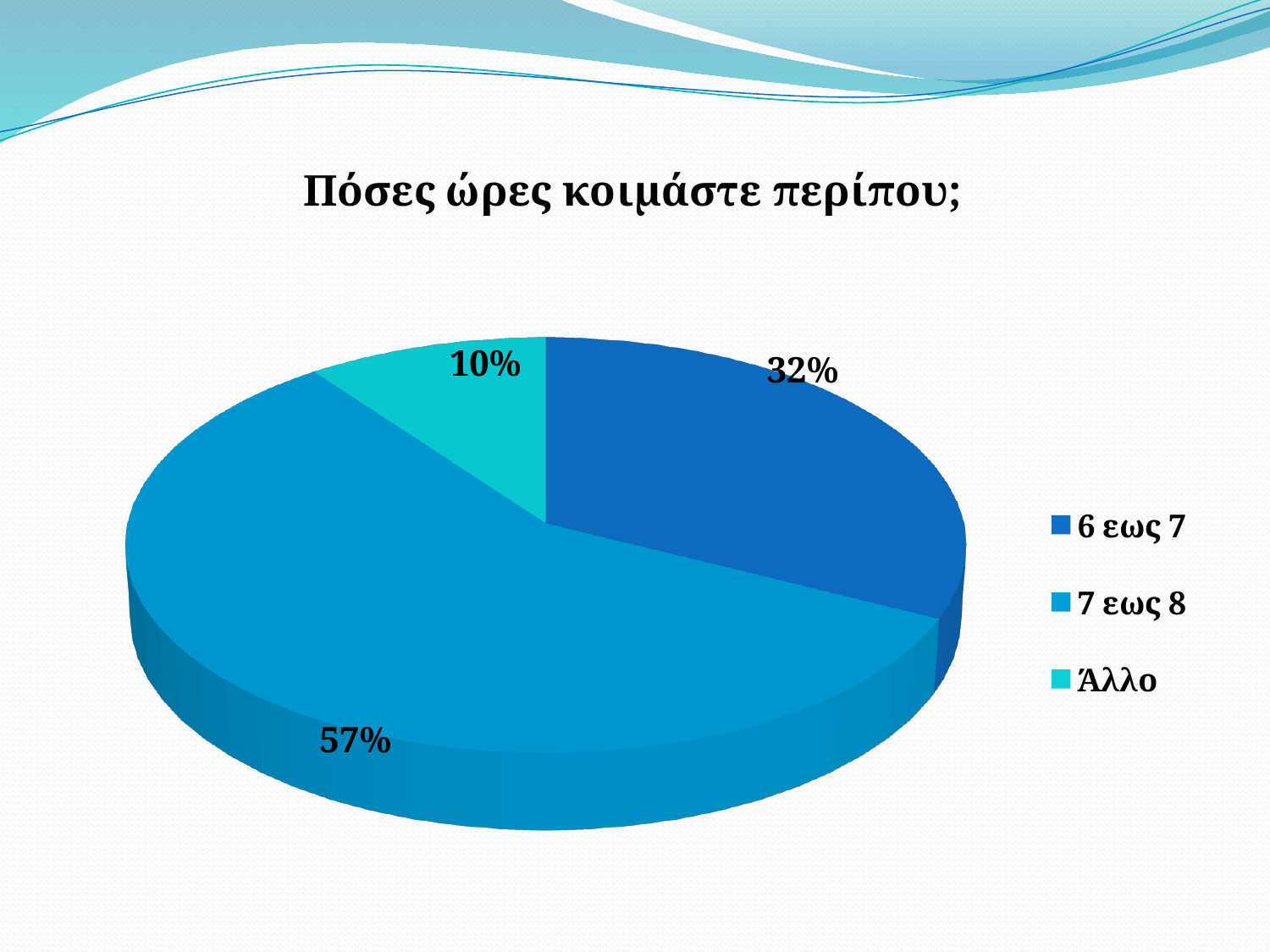
Which slice is larger, "6 εως 7" or "Άλλο"? 6 εως 7 How many categories does the pie chart show? 3 What is the difference in percentage points between the "6 εως 7" slice and the "Άλλο" slice? 22 What share of the pie does the "7 εως 8" slice represent? 57% Which category has the largest slice of the pie? 7 εως 8 Which category is shown in the lightest (turquoise) colour in the legend? Άλλο What is the title of the chart? Πόσες ώρες κοιμάστε περίπου; What kind of chart is shown on the slide? Pie chart What share of the pie does the "Άλλο" slice represent? 10% What share of the pie does the "6 εως 7" slice represent? 32% What is the difference in percentage points between the "7 εως 8" slice and the "6 εως 7" slice? 25 Which category has the smallest slice of the pie? Άλλο